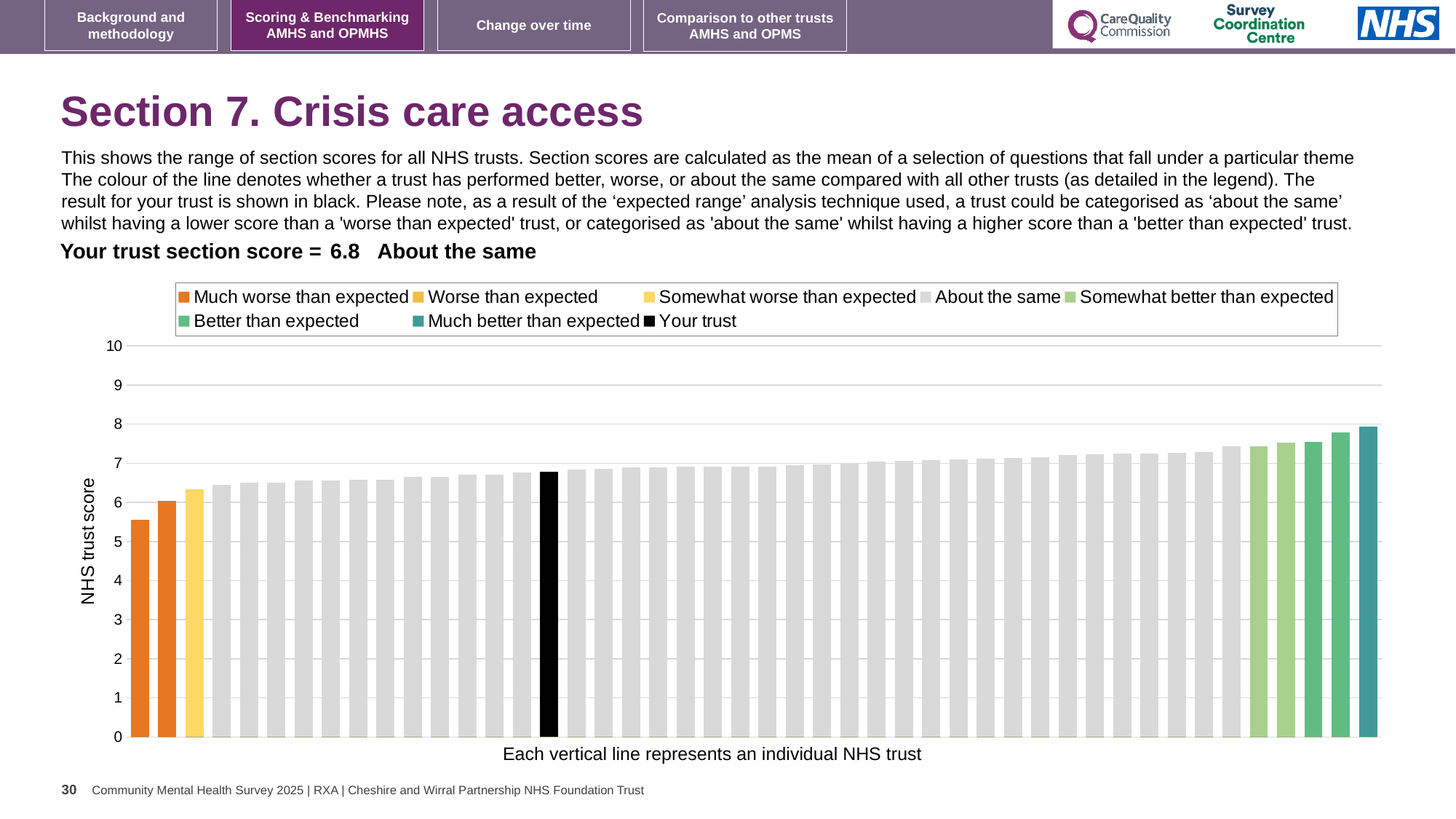
How many bars are coloured as 'Much worse than expected'? 2 Which legend category does the highest bar on the chart belong to? Much better than expected Which category is your trust placed in for this section? About the same Is the value of the lowest bar on the chart greater or less than 6? less Which legend category does the lowest bar on the chart belong to? Much worse than expected Is the value for your trust greater or less than 7? less What kind of chart is shown on the slide? bar chart Do the bar values rise or fall from left to right along the x axis? rise What is the label on the vertical axis of the chart? NHS trust score How many entries does the chart legend list? 8 Is the value of the highest bar on the chart greater or less than 7? greater What is the section score for your trust shown on the slide? 6.8